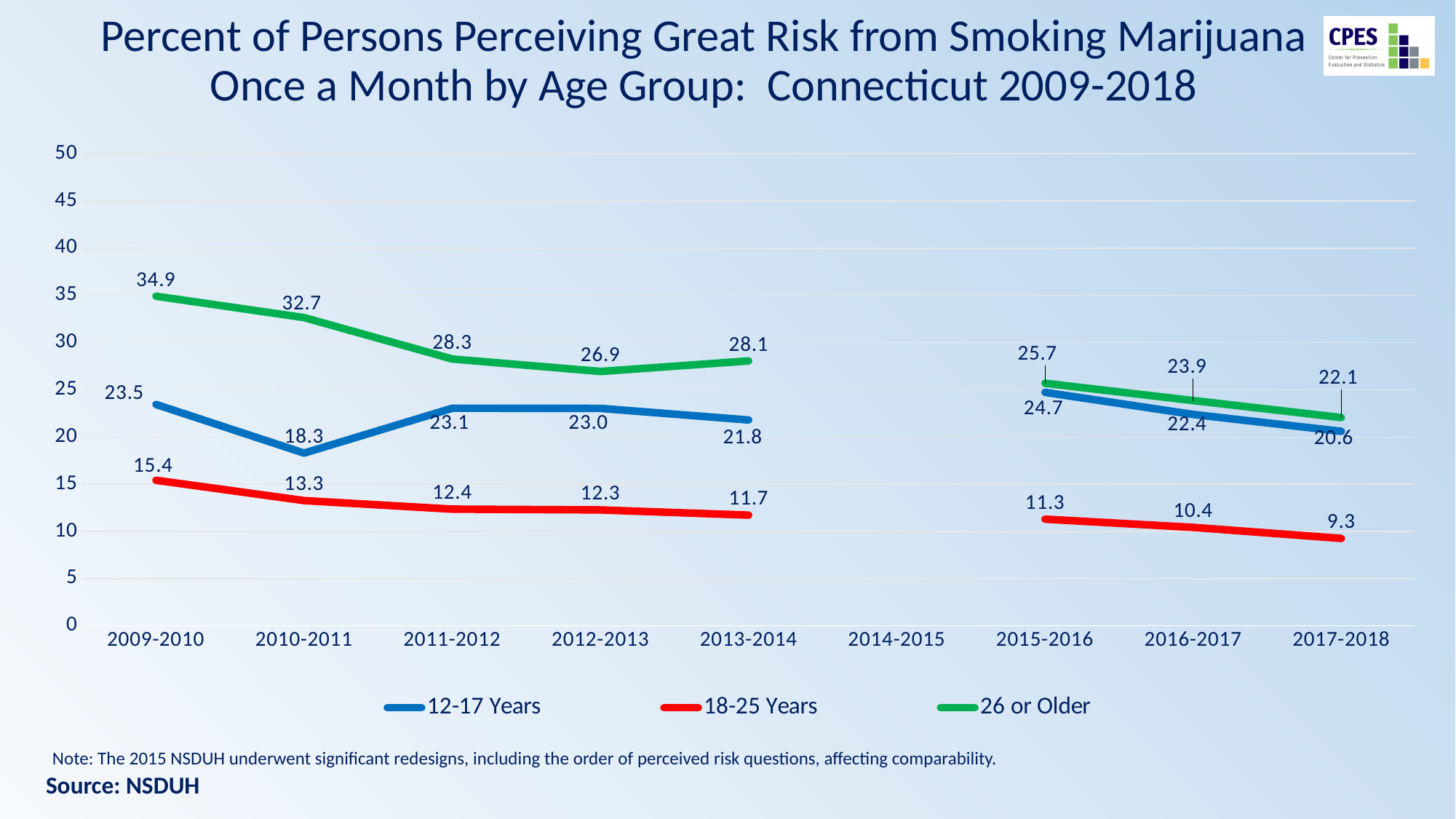
In which period is the 18-25 Years series at its lowest? 2017-2018 What is the difference between the 26 or Older and 12-17 Years values in 2009-2010? 11.4 Does the 18-25 Years series rise or fall from 2009-2010 to 2013-2014? Fall What kind of chart is shown on the slide? Line chart What is the value for the 12-17 Years series in 2010-2011? 18.3 Which is larger in 2015-2016: the 26 or Older value or the 12-17 Years value? 26 or Older What colour is the line for the 26 or Older series? Green What is the value for the 18-25 Years series in 2017-2018? 9.3 Is the value for 18-25 Years in 2009-2010 greater or less than 15? greater What is the value for the 26 or Older series in 2009-2010? 34.9 In which period is the 26 or Older series at its highest? 2009-2010 How many series does the legend list? 3